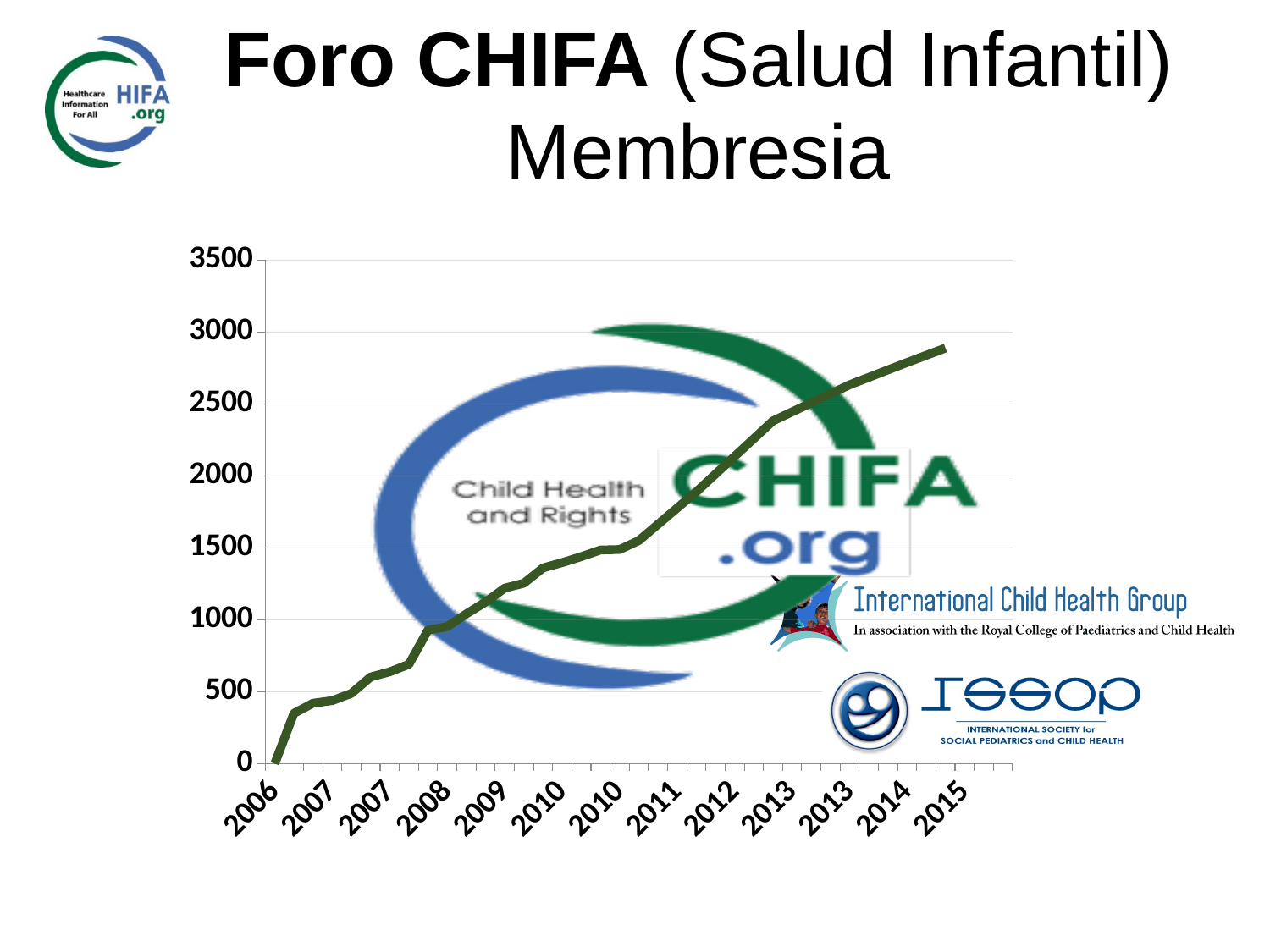
Is the value for 2014 greater or less than 2500? greater Which year on the x axis has the highest membership value? 2015 Is the value for 2015 greater or less than 2500? greater Is the value for the first 2013 label greater or less than 2000? greater Do the membership values rise or fall from 2006 to 2015? rise How many year labels are shown along the x axis? 13 What kind of chart is shown on the slide? line chart What is the highest value shown on the y axis? 3500 Which year on the x axis has the lowest membership value? 2006